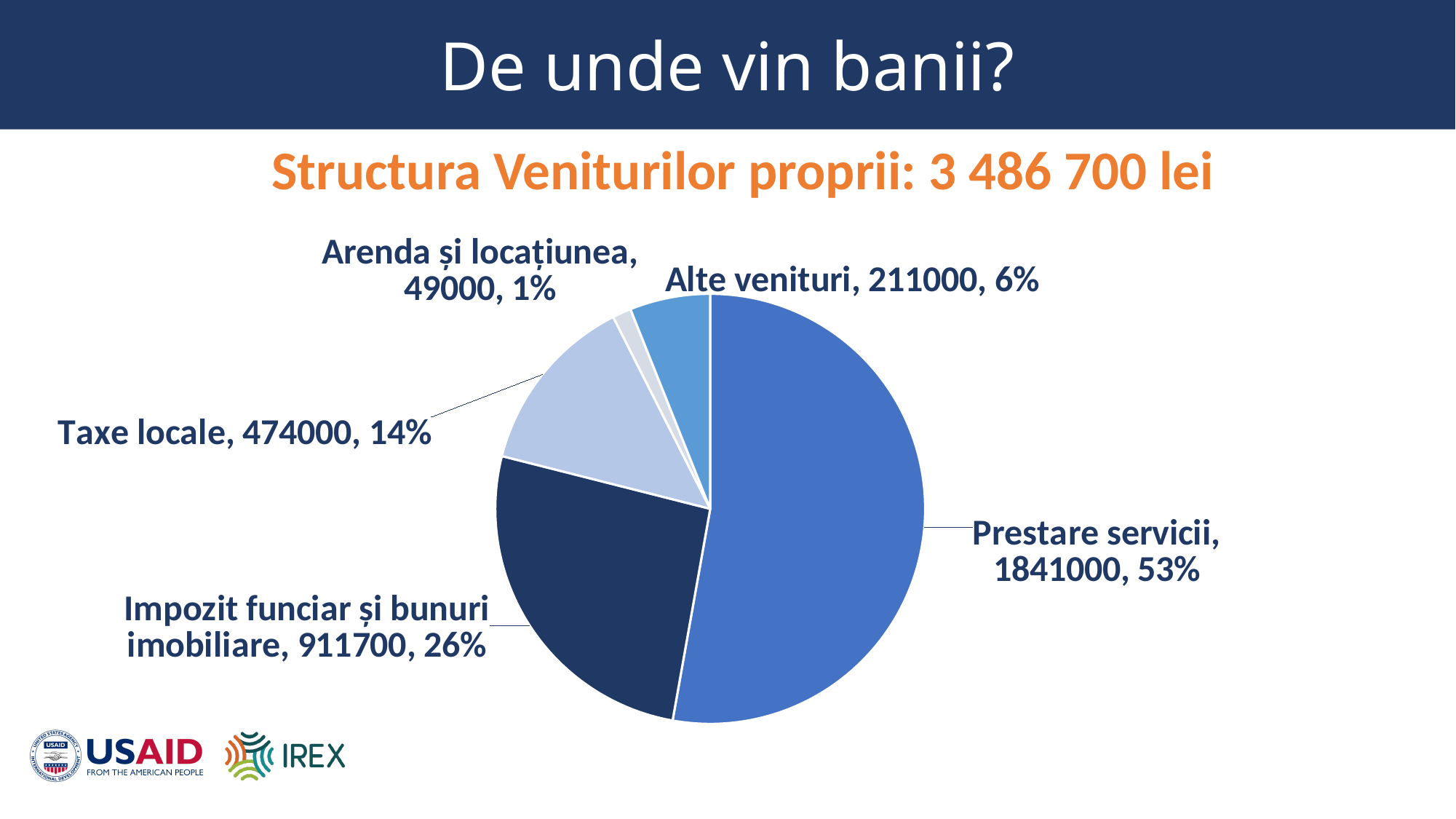
What is the value for Taxe locale? 474000 Which category has the smallest slice of the pie? Arenda și locațiunea How many categories are shown in the pie chart? 5 What is the value for Prestare servicii? 1841000 What is the value for Arenda și locațiunea? 49000 What kind of chart is shown on the slide? pie chart What share of the pie does Impozit funciar și bunuri imobiliare represent? 26% Which is larger, the value for Taxe locale or the value for Alte venituri? Taxe locale Which category has the largest slice of the pie? Prestare servicii What share of the pie does Alte venituri represent? 6% What total amount is stated in the chart title? 3 486 700 lei What is the difference between the values for Prestare servicii and Impozit funciar și bunuri imobiliare? 929300